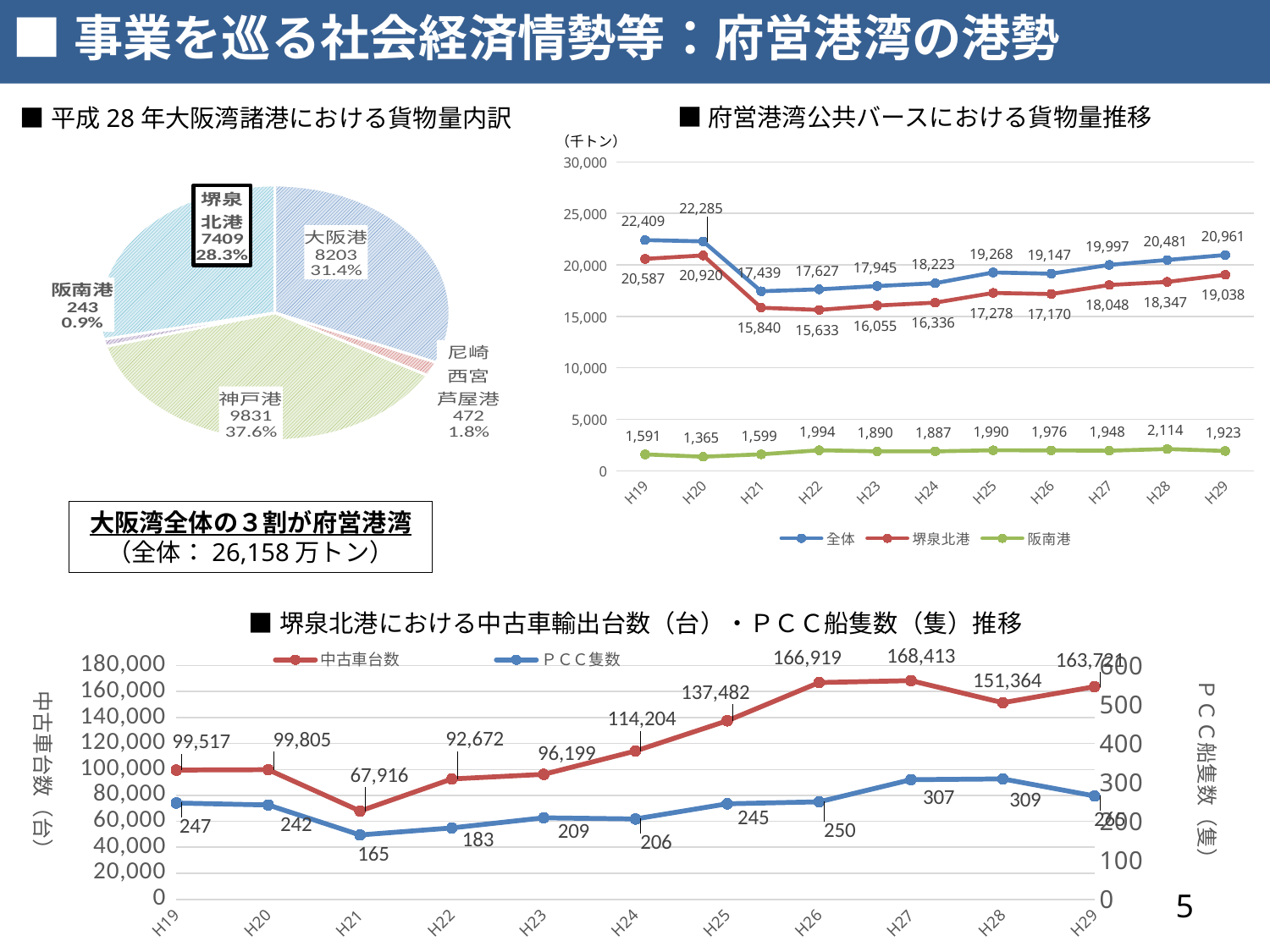
In the pie chart 平成28年大阪湾諸港における貨物量内訳, which port has the largest slice? 神戸港 In the pie chart 平成28年大阪湾諸港における貨物量内訳, which port has the smallest slice? 阪南港 In the line chart 府営港湾公共バースにおける貨物量推移, in which year is 堺泉北港 at its lowest? H22 What kind of chart is the bottom chart 堺泉北港における中古車輸出台数・PCC船隻数推移? line chart In the line chart 府営港湾公共バースにおける貨物量推移, in which year does 阪南港 reach its highest value? H28 In the line chart 府営港湾公共バースにおける貨物量推移, what is the value of 全体 for H19? 22,409 In the pie chart 平成28年大阪湾諸港における貨物量内訳, what share does 神戸港 have? 37.6% In the bottom chart 堺泉北港における中古車輸出台数・PCC船隻数推移, in which year is PCC隻数 at its lowest? H21 How many slices does the pie chart 平成28年大阪湾諸港における貨物量内訳 have? 5 In the bottom chart 堺泉北港における中古車輸出台数・PCC船隻数推移, what is the 中古車台数 value for H27? 168,413 In the line chart 府営港湾公共バースにおける貨物量推移, what is the difference between 全体 and 堺泉北港 in H29? 1,923 How many series does the legend of the line chart 府営港湾公共バースにおける貨物量推移 list? 3